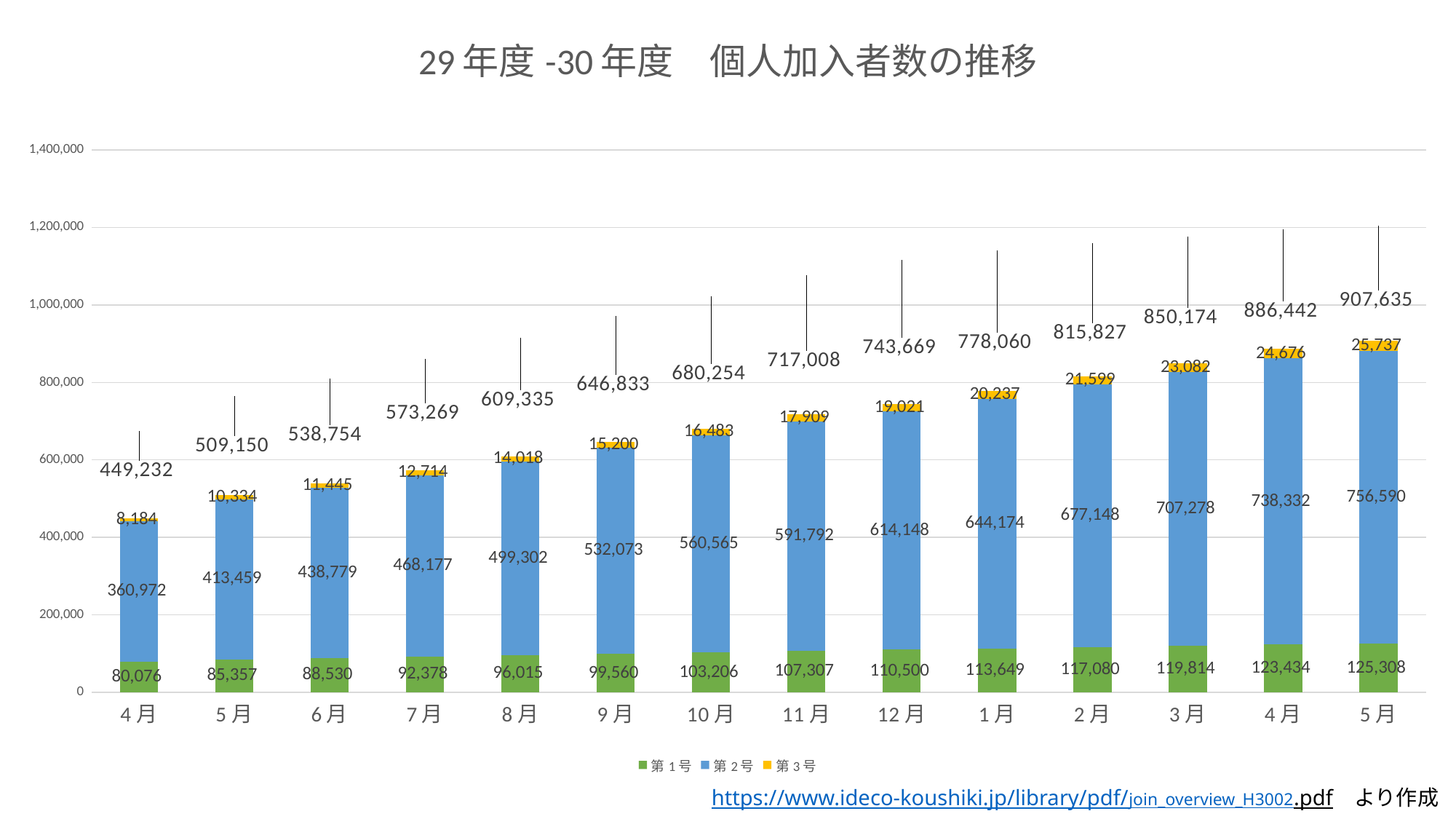
Do the bar totals rise or fall from left to right along the x axis? rise Is the 第2号 value for 6月 greater or less than 400,000? greater What is the total shown above the stacked bar for 1月? 778,060 Which bar has the lowest 第1号 value? the leftmost bar (4月) Which is larger, the 第1号 value for 9月 or for 11月? 11月 Which bar has the highest total? the rightmost bar (5月) How many stacked bars (months) are shown on the chart? 14 What is the value of 第1号 for 12月? 110,500 How many series does the legend list? 3 What is the value of 第2号 for 10月? 560,565 What is the value of 第3号 for 8月? 14,018 What is the difference between the 第2号 values for 3月 and 2月? 30,130